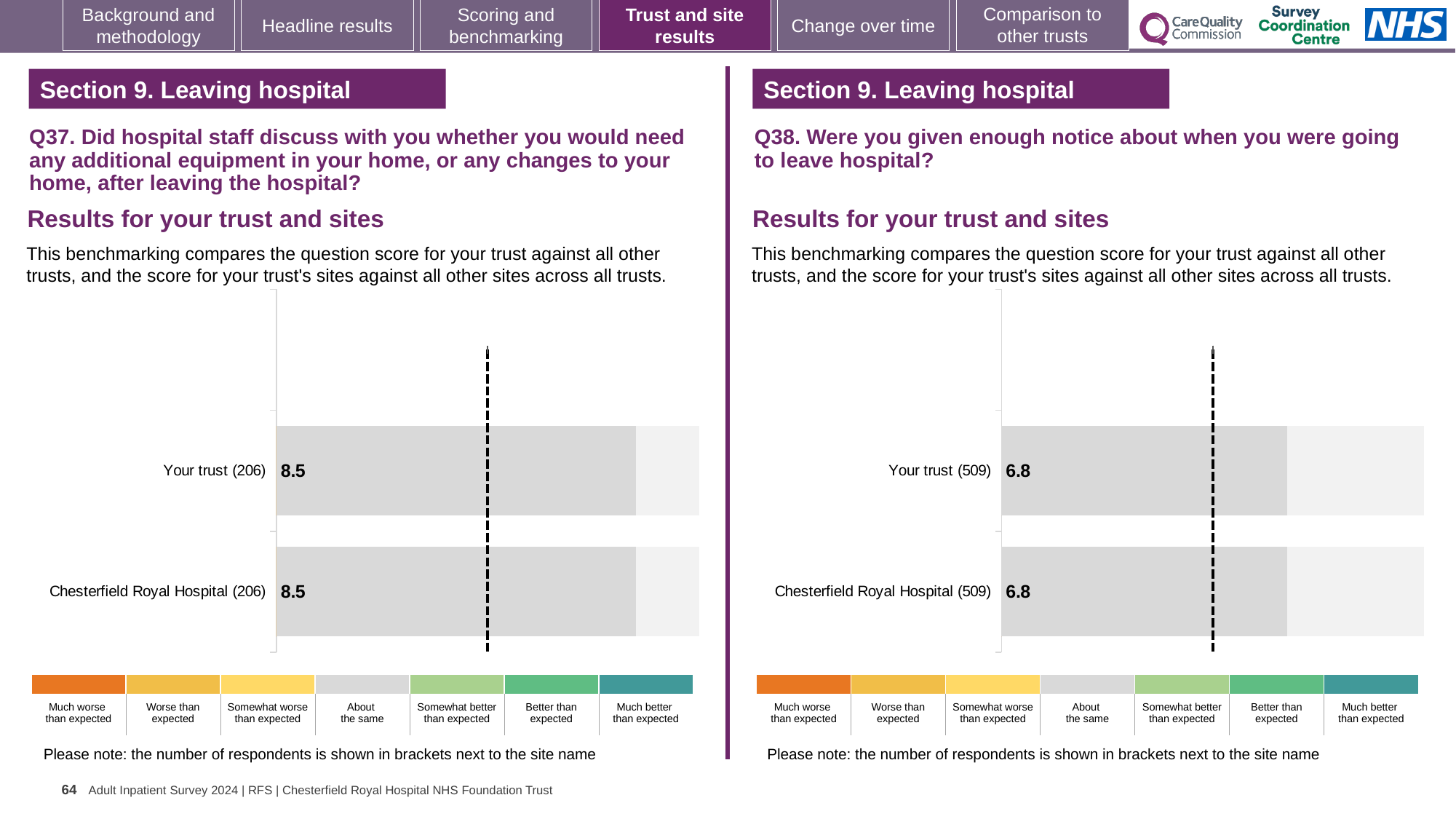
What is the difference between the Your trust score in the Q37 chart on the left and the Your trust score in the Q38 chart on the right? 1.7 In the Q37 chart on the left, how many respondents are shown in brackets next to Your trust? 206 In the Q38 chart on the right, what is the score for Your trust? 6.8 In the Q37 chart on the left, what is the score for Chesterfield Royal Hospital? 8.5 In the Q37 chart on the left, is the score for Your trust larger than, smaller than, or the same as the score for Chesterfield Royal Hospital? the same In the Q37 chart on the left, what is the score for Your trust? 8.5 How many categories does the colour key below the Q38 chart on the right list? 7 How many bars are plotted in the Q38 chart on the right? 2 Which is larger: the Your trust score in the Q37 chart on the left or the Your trust score in the Q38 chart on the right? Q37 (8.5) In the Q38 chart on the right, how many respondents are shown in brackets next to Chesterfield Royal Hospital? 509 In the Q38 chart on the right, what is the score for Chesterfield Royal Hospital? 6.8 What type of chart is used for the Q37 results on the left? bar chart